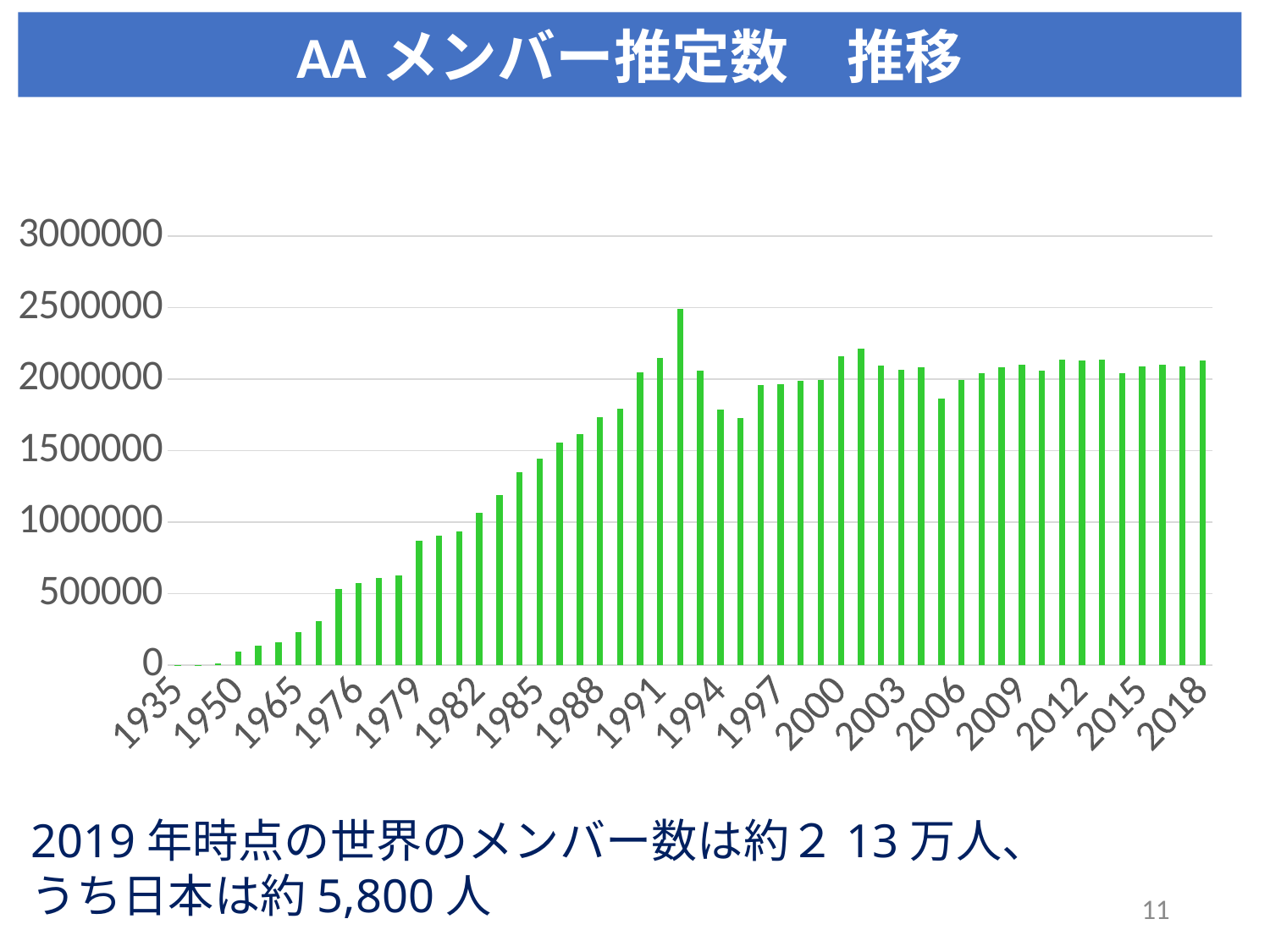
Do the values generally rise or fall from 1935 to 1991? rise Is the value for 1979 greater or less than 500000? greater Which has the larger value, 1965 or 2018? 2018 What is the title of the chart? AA メンバー推定数 推移 Which has the larger value, 1979 or 1985? 1985 What colour are the bars in the chart? green Is the value for 1988 greater or less than 1500000? greater What kind of chart is shown on the slide? bar chart Is the value for 1935 greater or less than 500000? less